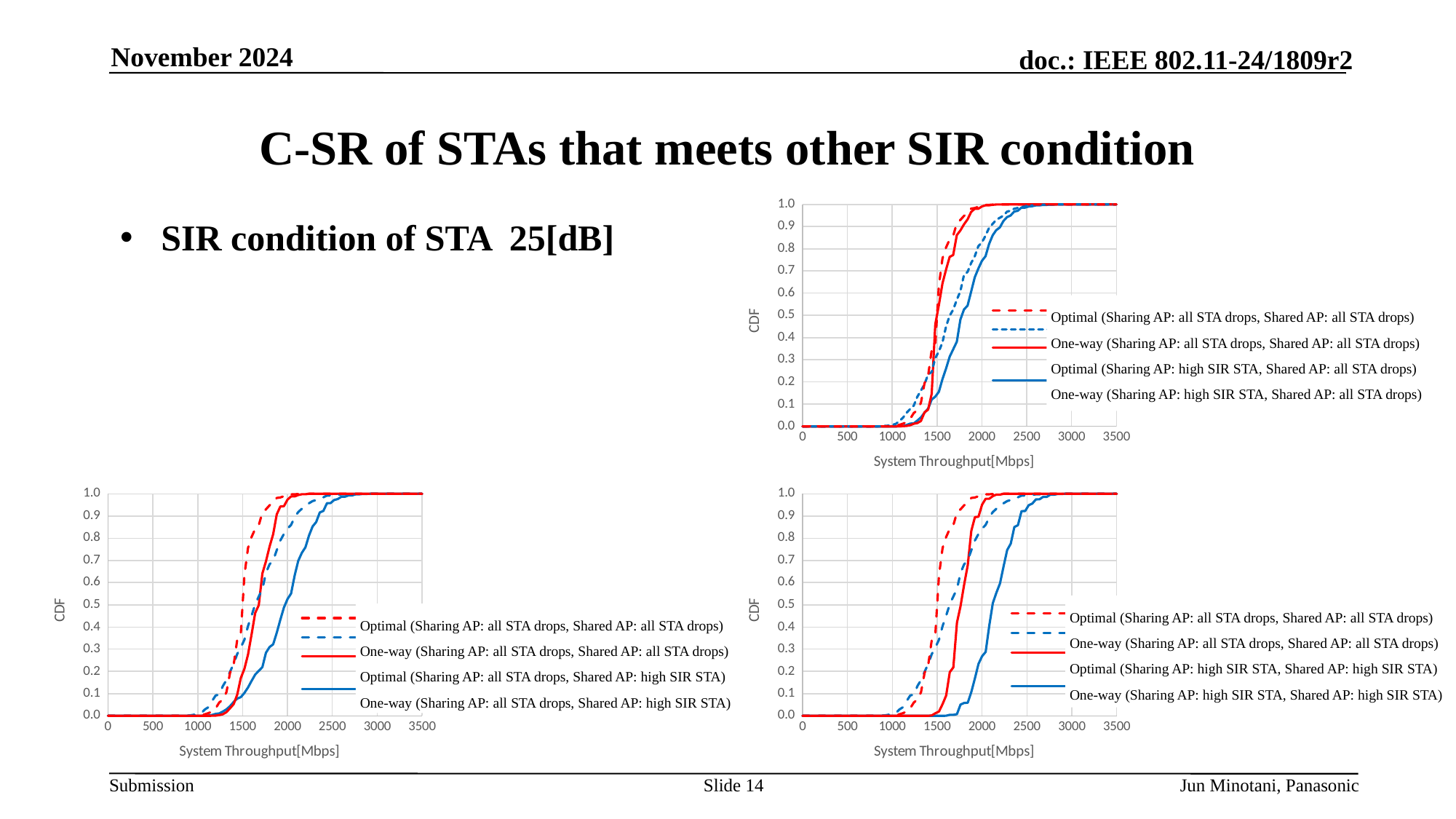
What kind of chart is the top-right chart on the slide? line chart How many series does the legend of the bottom-right chart list? 4 What is the maximum value shown on the x axis of the bottom-left chart? 3500 In the bottom-right chart, do the curves rise or fall as system throughput increases along the x axis? rise In the bottom-right chart, at a system throughput of 1500 Mbps, is the CDF of the solid blue line (One-way, Sharing AP: high SIR STA, Shared AP: high SIR STA) greater or less than 0.5? less How many series does the legend of the bottom-left chart list? 4 What is the x-axis label of the top-right chart? System Throughput[Mbps] What is the y-axis label of the bottom-left chart? CDF In the top-right chart, at a system throughput of 1000 Mbps, is the CDF of the solid red line (One-way, Sharing AP: all STA drops, Shared AP: all STA drops) greater or less than 0.1? less In the bottom-left chart, at a system throughput of 2500 Mbps, is the CDF of the dashed red line (Optimal, Sharing AP: all STA drops, Shared AP: all STA drops) greater or less than 0.9? greater In the bottom-right chart, at a system throughput of 1500 Mbps, which has the higher CDF: the dashed red line (Optimal, all STA drops / all STA drops) or the solid blue line (One-way, high SIR STA / high SIR STA)? the dashed red line How many tick labels are shown on the x axis of the top-right chart? 8